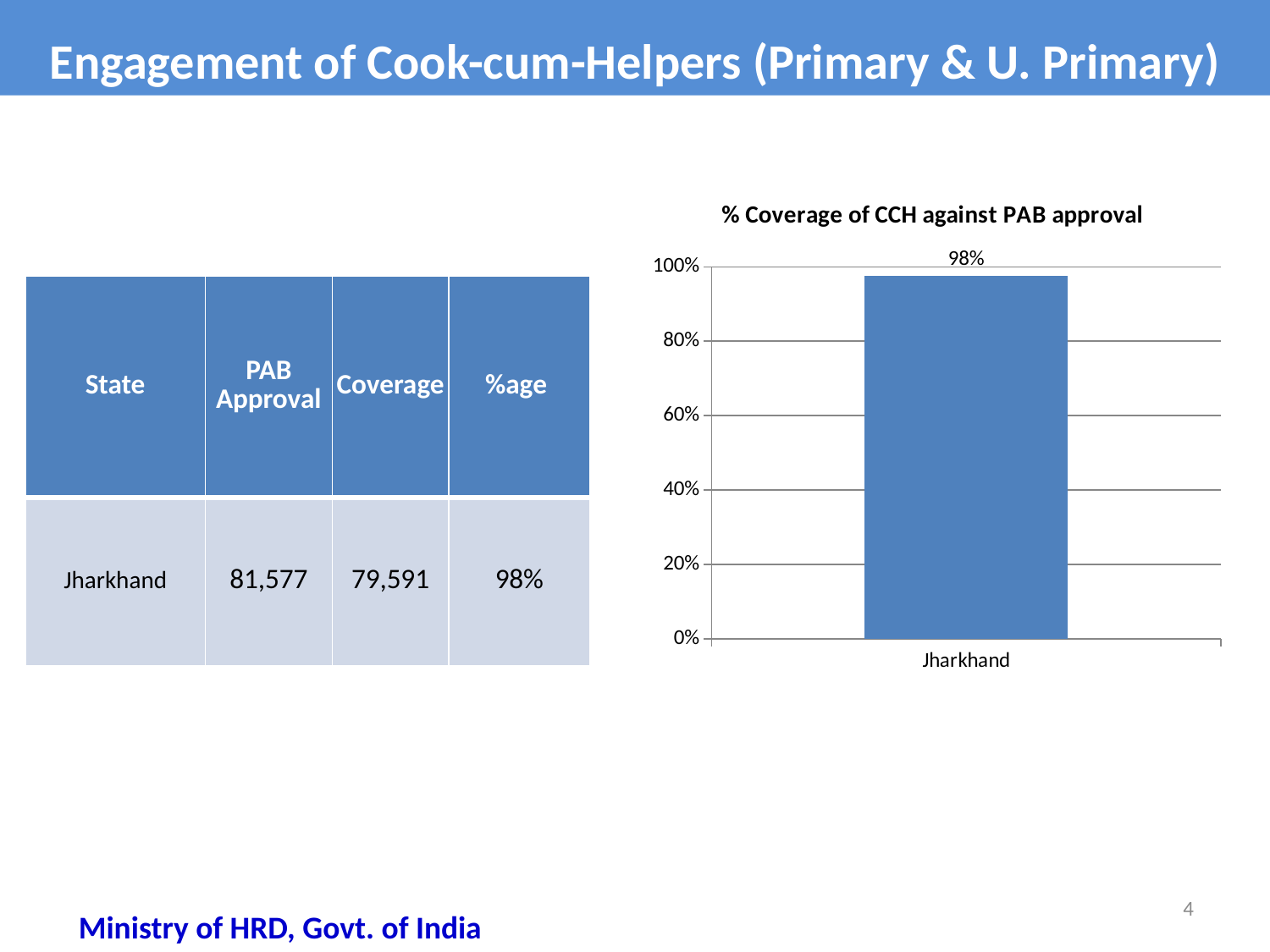
Is the value for Jharkhand greater or less than 80%? greater What is the value shown for Jharkhand in the chart? 98% What is the highest value shown on the y axis of the chart? 100% How many categories are plotted in the chart? 1 What type of chart is shown on the slide? bar chart What is the title of the chart? % Coverage of CCH against PAB approval Is the value for Jharkhand greater or less than 100%? less Which state is shown on the x axis of the chart? Jharkhand